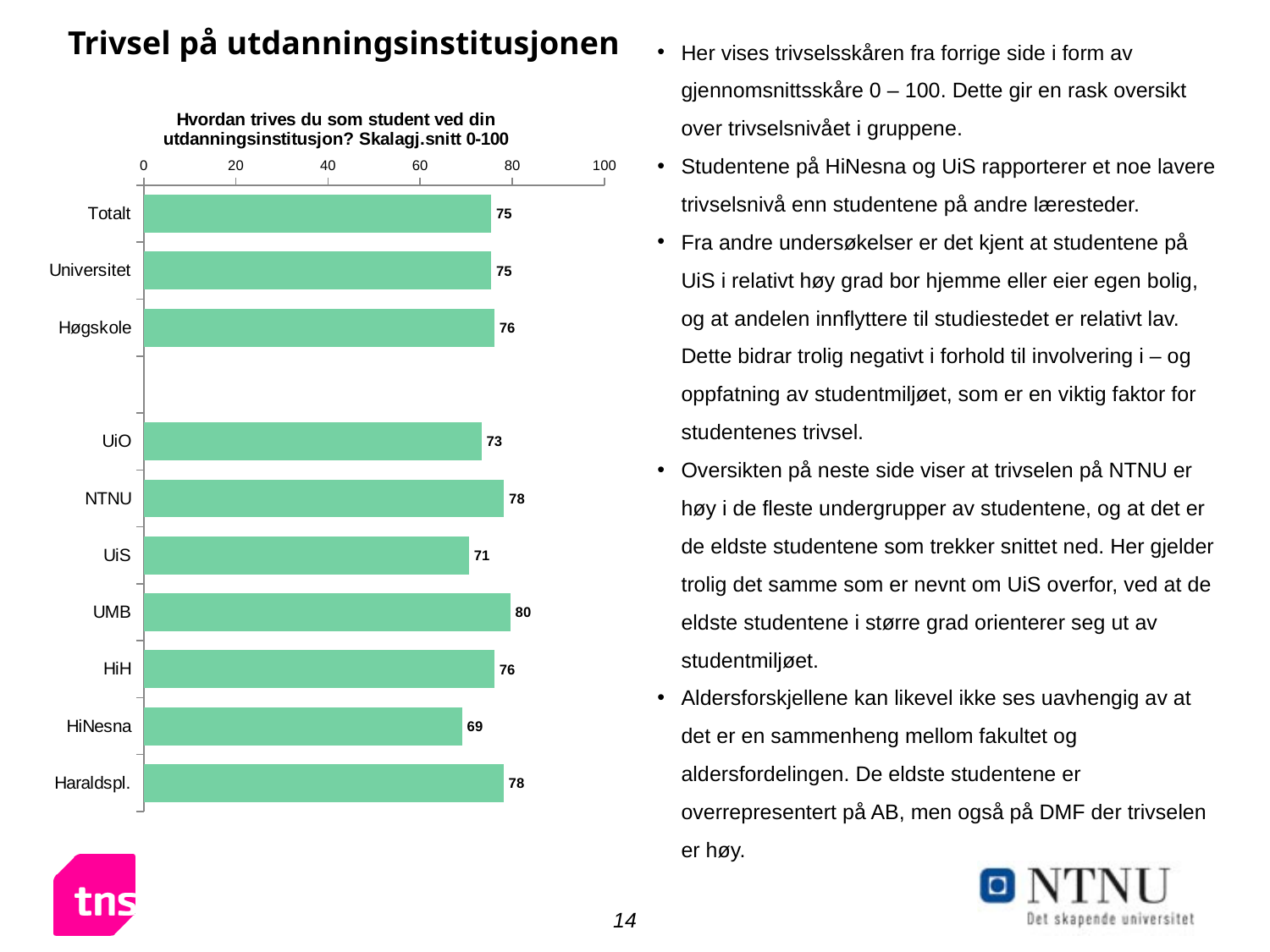
What is the value for HiNesna? 69 What is the value for Totalt? 75 Which category has the highest value? UMB What is the maximum value shown on the chart's axis? 100 What is the difference between the values for UMB and HiNesna? 11 What kind of chart is shown on the slide? Bar chart What is the value for UiS? 71 What is the value for NTNU? 78 How many categories are shown in the chart? 10 What is the difference between the values for NTNU and UiO? 5 Which category has the lowest value? HiNesna Which has a higher value, UiO or Haraldspl.? Haraldspl.